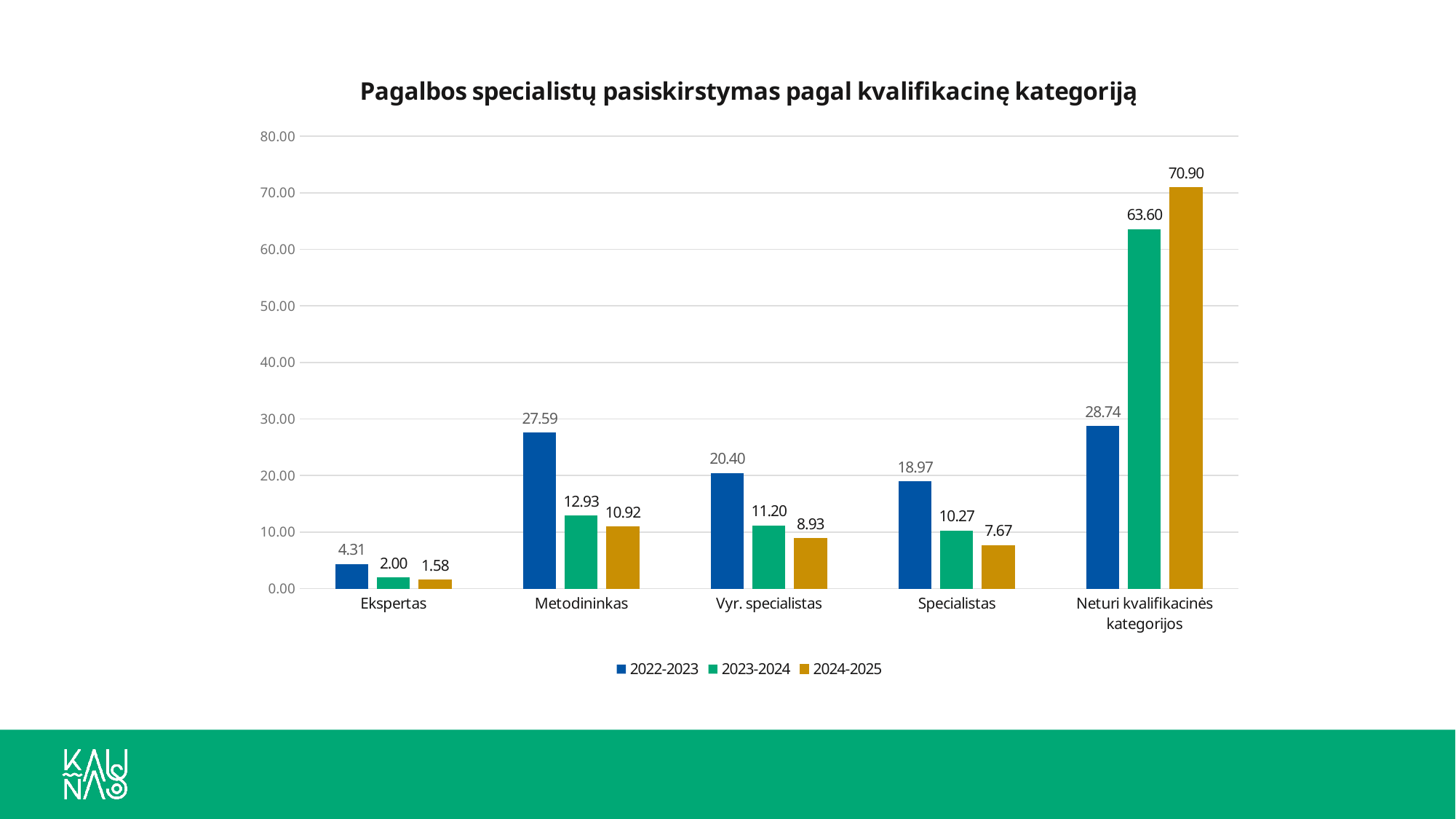
How many categories are shown on the x axis? 5 What kind of chart is shown on the slide? Bar chart Which category has the lowest value in the 2022-2023 series? Ekspertas What is the title of the chart? Pagalbos specialistų pasiskirstymas pagal kvalifikacinę kategoriją Is the value for Vyr. specialistas in 2022-2023 greater or less than 20.00? greater What is the value for Metodininkas in the 2022-2023 series? 27.59 What is the value for Neturi kvalifikacinės kategorijos in the 2024-2025 series? 70.90 How many series does the legend list? 3 Which is larger for Specialistas: the 2022-2023 value or the 2023-2024 value? 2022-2023 Which category has the highest value in the 2023-2024 series? Neturi kvalifikacinės kategorijos What is the difference between the 2024-2025 and 2022-2023 values for Neturi kvalifikacinės kategorijos? 42.16 What is the value for Ekspertas in the 2023-2024 series? 2.00